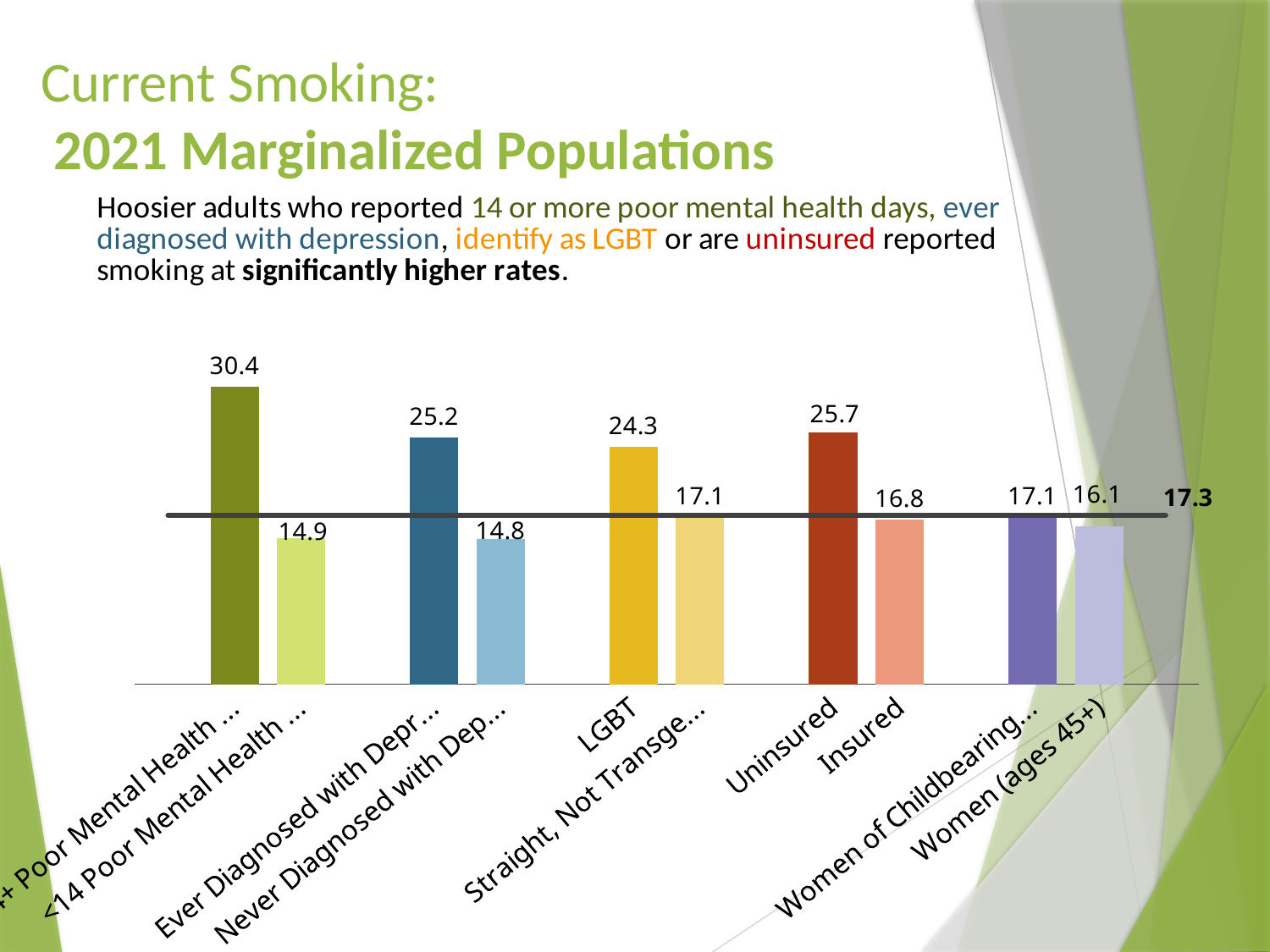
What is the highest value shown on the chart? 30.4 Which is larger, the value for Insured or the value for Women (ages 45+)? Insured How many bars are plotted on the chart? 10 What is the difference between the Uninsured and Insured values? 8.9 What is the difference between the Uninsured and LGBT values? 1.4 What is the value for Women (ages 45+)? 16.1 What is the lowest value shown on the chart? 14.8 What is the value for LGBT? 24.3 What is the value for Insured? 16.8 What kind of chart is shown on the slide? Bar chart What is the value for Uninsured? 25.7 Which is larger, the value for LGBT or the value for Uninsured? Uninsured